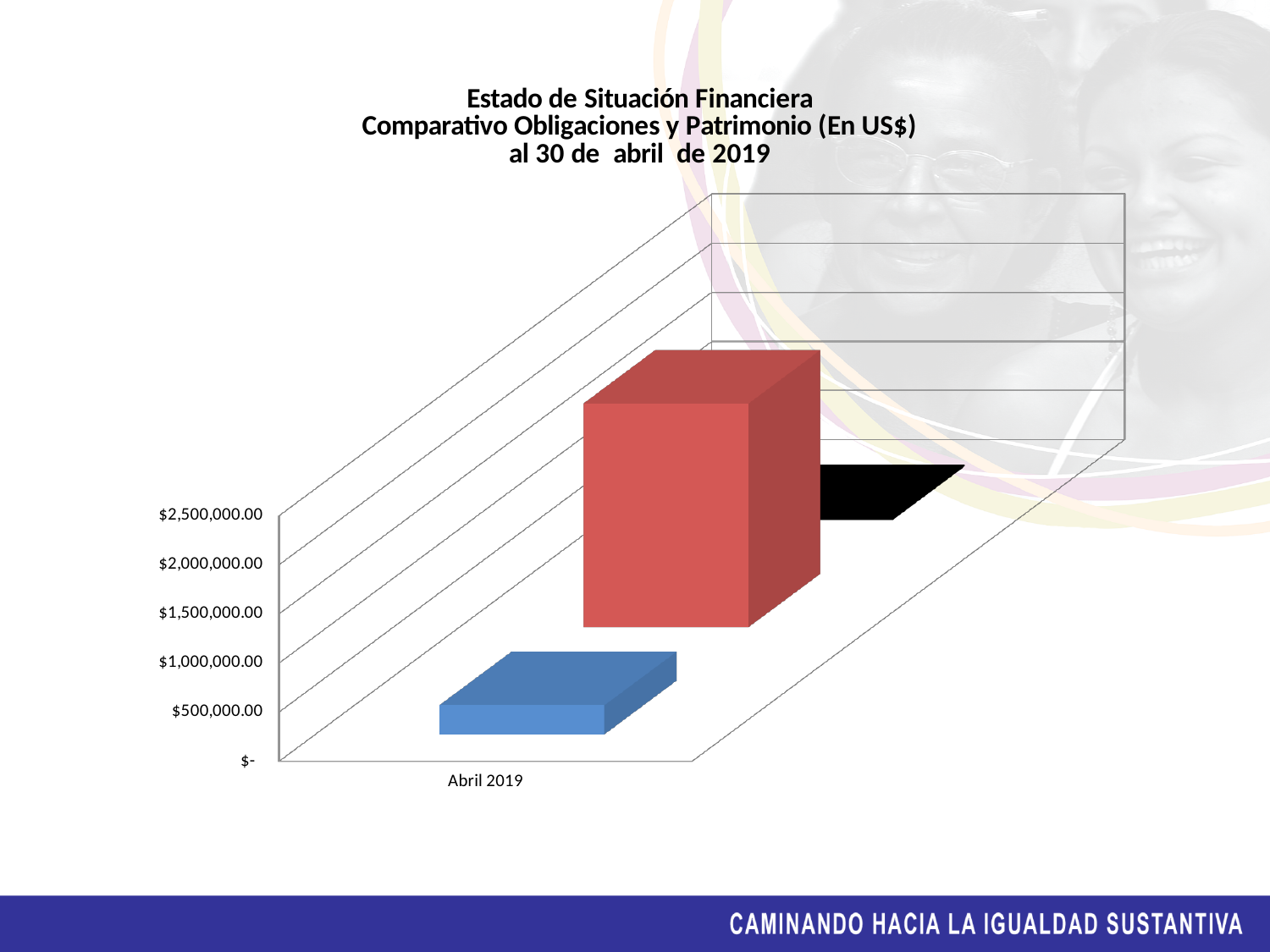
Is the value of the blue bar for Abril 2019 greater or less than $500,000.00? less What is the category label shown on the x axis of the chart? Abril 2019 Which bar is taller for Abril 2019, the blue bar or the red bar? the red bar Is the value of the red bar for Abril 2019 greater or less than $1,500,000.00? greater What is the highest value shown on the vertical axis of the chart? $2,500,000.00 Is the value of the red bar for Abril 2019 greater or less than $1,000,000.00? greater What date does the chart title say the financial comparison is as of? al 30 de abril de 2019 How many categories are shown on the x axis of the chart? 1 What kind of chart is shown on the slide? bar chart